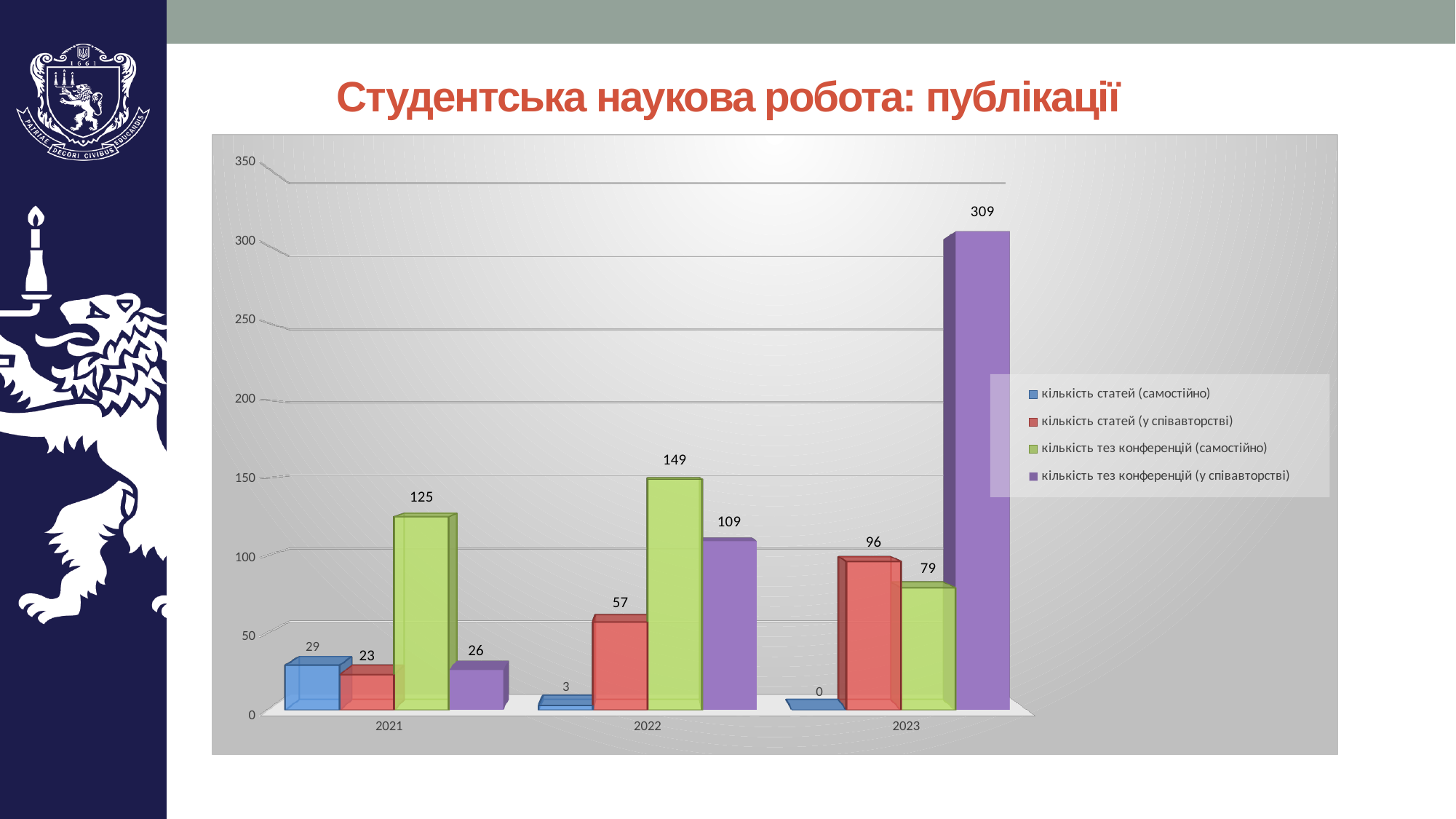
What is the value for кількість тез конференцій (у співавторстві) in 2023? 309 What is the difference between кількість тез конференцій (самостійно) in 2022 and in 2023? 70 Does кількість статей (у співавторстві) rise or fall from 2021 to 2023? rise What is the value for кількість статей (у співавторстві) in 2023? 96 In which year is кількість статей (самостійно) lowest? 2023 In which year is кількість тез конференцій (у співавторстві) highest? 2023 Which is larger in 2022: кількість статей (у співавторстві) or кількість тез конференцій (у співавторстві)? кількість тез конференцій (у співавторстві) What kind of chart is shown on the slide? bar chart How many years are shown on the x axis? 3 What is the value for кількість статей (самостійно) in 2021? 29 What is the value for кількість тез конференцій (самостійно) in 2022? 149 How many series does the legend list? 4